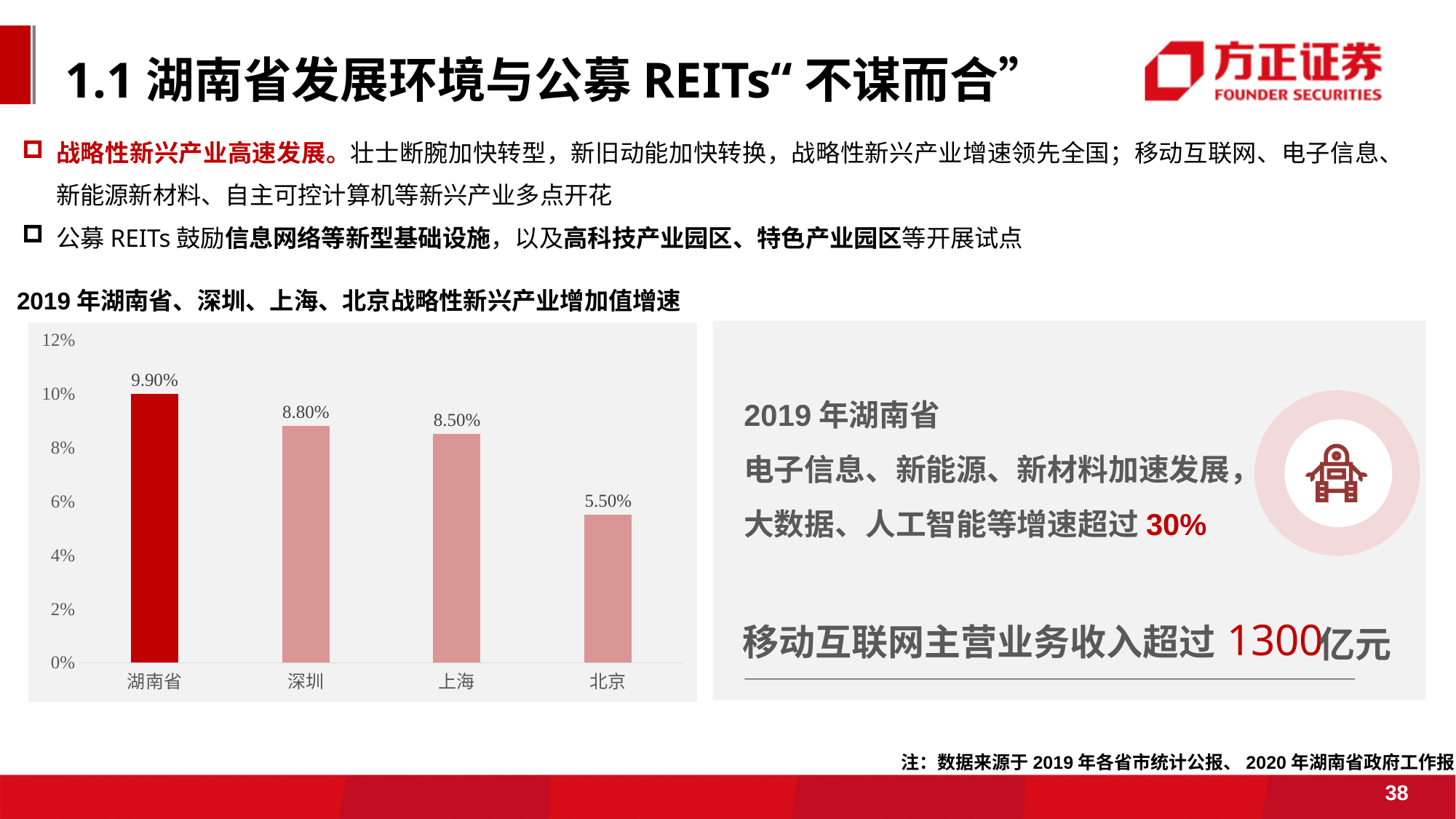
How many categories are shown in the chart? 4 Which category has the highest value in the chart? 湖南省 What is the value for 湖南省 in the chart? 9.90% What is the value for 深圳 in the chart? 8.80% What is the title of the chart? 2019年湖南省、深圳、上海、北京战略性新兴产业增加值增速 What is the value for 北京 in the chart? 5.50% What kind of chart is shown on the slide? bar chart Is the value for 北京 greater or less than 6%? less Which is larger, the value for 深圳 or the value for 上海? 深圳 Which category has the lowest value in the chart? 北京 What is the difference between the values for 湖南省 and 北京? 4.40% What is the value for 上海 in the chart? 8.50%